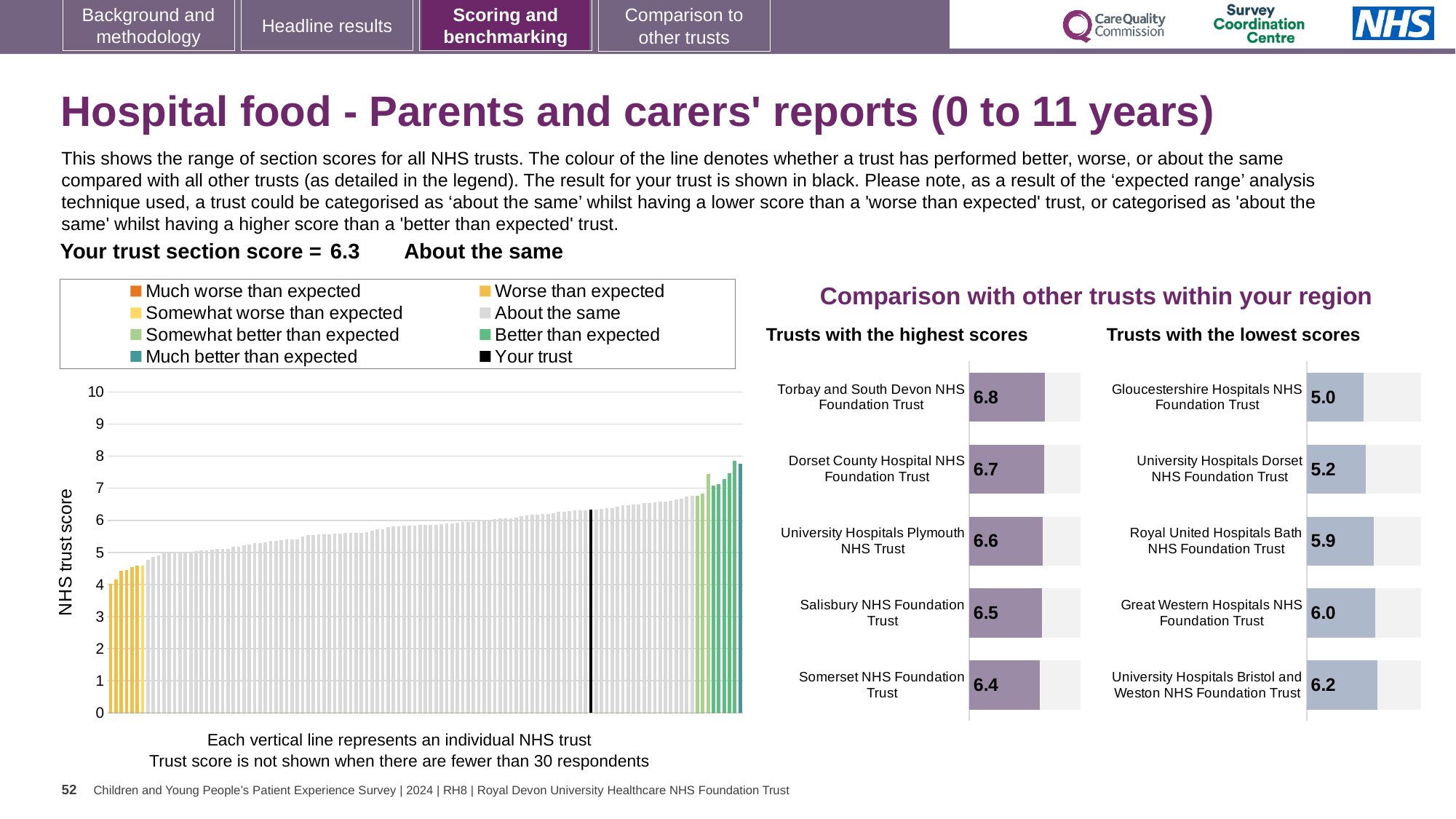
In the 'Trusts with the lowest scores' chart, what is the difference between the scores of University Hospitals Bristol and Weston NHS Foundation Trust and Gloucestershire Hospitals NHS Foundation Trust? 1.2 In the 'Trusts with the highest scores' chart, what is the score for Torbay and South Devon NHS Foundation Trust? 6.8 In the NHS trust score chart on the left, is the value for your trust (the black bar) greater or less than 6? greater How many entries does the legend of the NHS trust score chart on the left list? 8 In the 'Trusts with the lowest scores' chart, which has the larger score: University Hospitals Dorset NHS Foundation Trust or Great Western Hospitals NHS Foundation Trust? Great Western Hospitals NHS Foundation Trust In the 'Trusts with the highest scores' chart, which trust has the highest score? Torbay and South Devon NHS Foundation Trust In the 'Trusts with the lowest scores' chart, which trust has the lowest score? Gloucestershire Hospitals NHS Foundation Trust In the 'Trusts with the lowest scores' chart, what is the score for Royal United Hospitals Bath NHS Foundation Trust? 5.9 In the 'Trusts with the lowest scores' chart, what is the score for Gloucestershire Hospitals NHS Foundation Trust? 5.0 In the 'Trusts with the highest scores' chart, what is the score for Salisbury NHS Foundation Trust? 6.5 How many trusts are listed in the 'Trusts with the highest scores' chart? 5 In the 'Trusts with the highest scores' chart, what is the difference between the scores of Torbay and South Devon NHS Foundation Trust and Somerset NHS Foundation Trust? 0.4